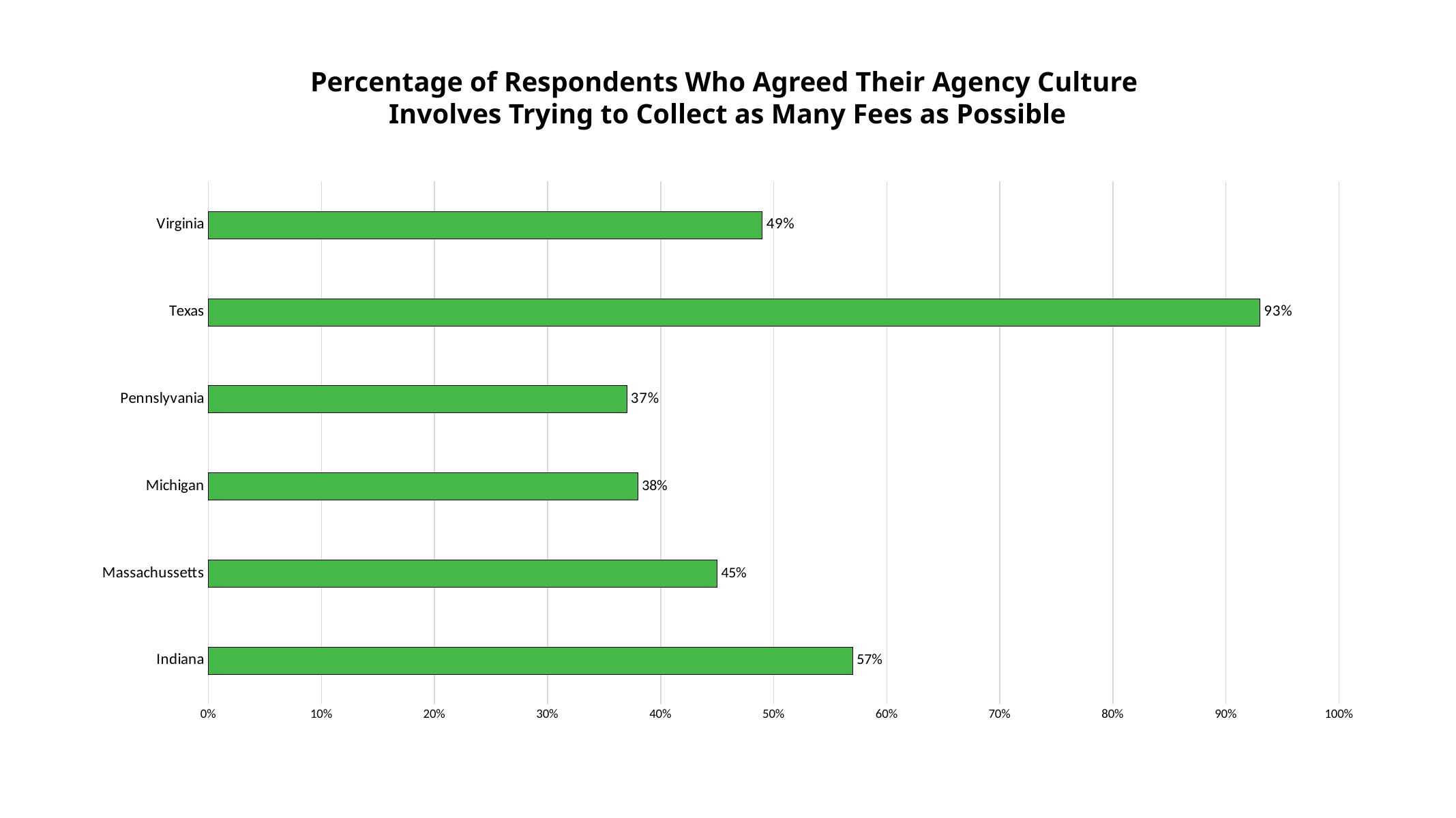
What percentage of respondents in Texas agreed their agency culture involves trying to collect as many fees as possible? 93% What is the difference between the values for Texas and Indiana? 36% Is the value for Michigan greater or less than 40%? less How many states are shown in the chart? 6 What is the value shown for Virginia? 49% What colour are the bars in the chart? Green Which state has the highest percentage of respondents who agreed? Texas What is the difference between the values for Virginia and Massachussetts? 4% Which has a larger value, Indiana or Virginia? Indiana Which state has the lowest percentage of respondents who agreed? Pennslyvania What kind of chart is shown on the slide? Bar chart What is the value shown for Massachussetts? 45%